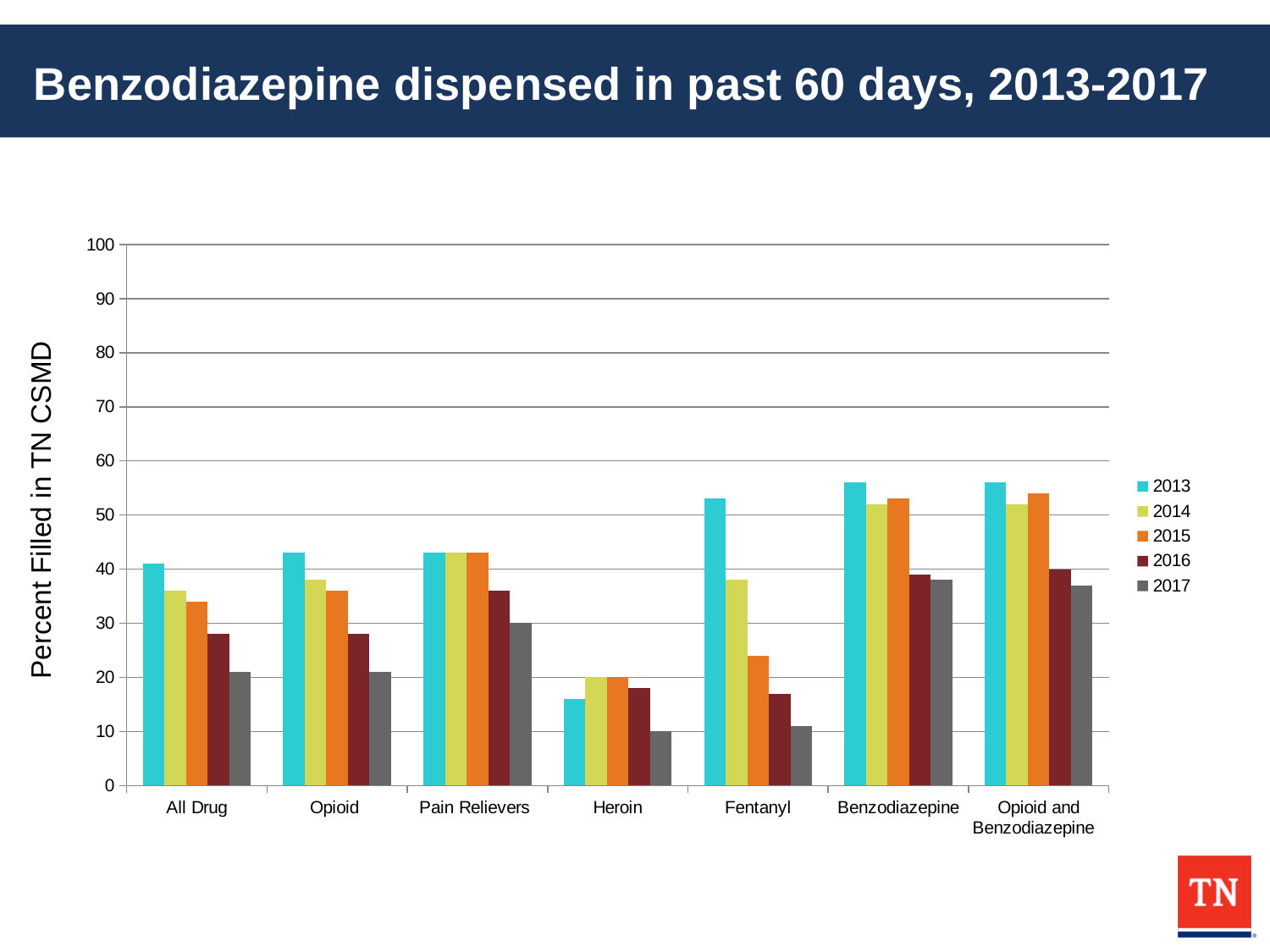
Do the values for Fentanyl rise or fall from 2013 to 2017? fall What is the label on the vertical axis? Percent Filled in TN CSMD How many series does the legend list? 5 Is the 2017 value for All Drug greater or less than 30? less How many categories are shown on the x axis? 7 Is the 2013 value for Benzodiazepine greater or less than 50? greater Which category has the lowest 2013 value? Heroin What kind of chart is shown on the slide? bar chart Which category has the lowest 2014 value? Heroin Which years are listed in the legend? 2013, 2014, 2015, 2016, 2017 Is the 2013 value for Heroin greater or less than 20? less